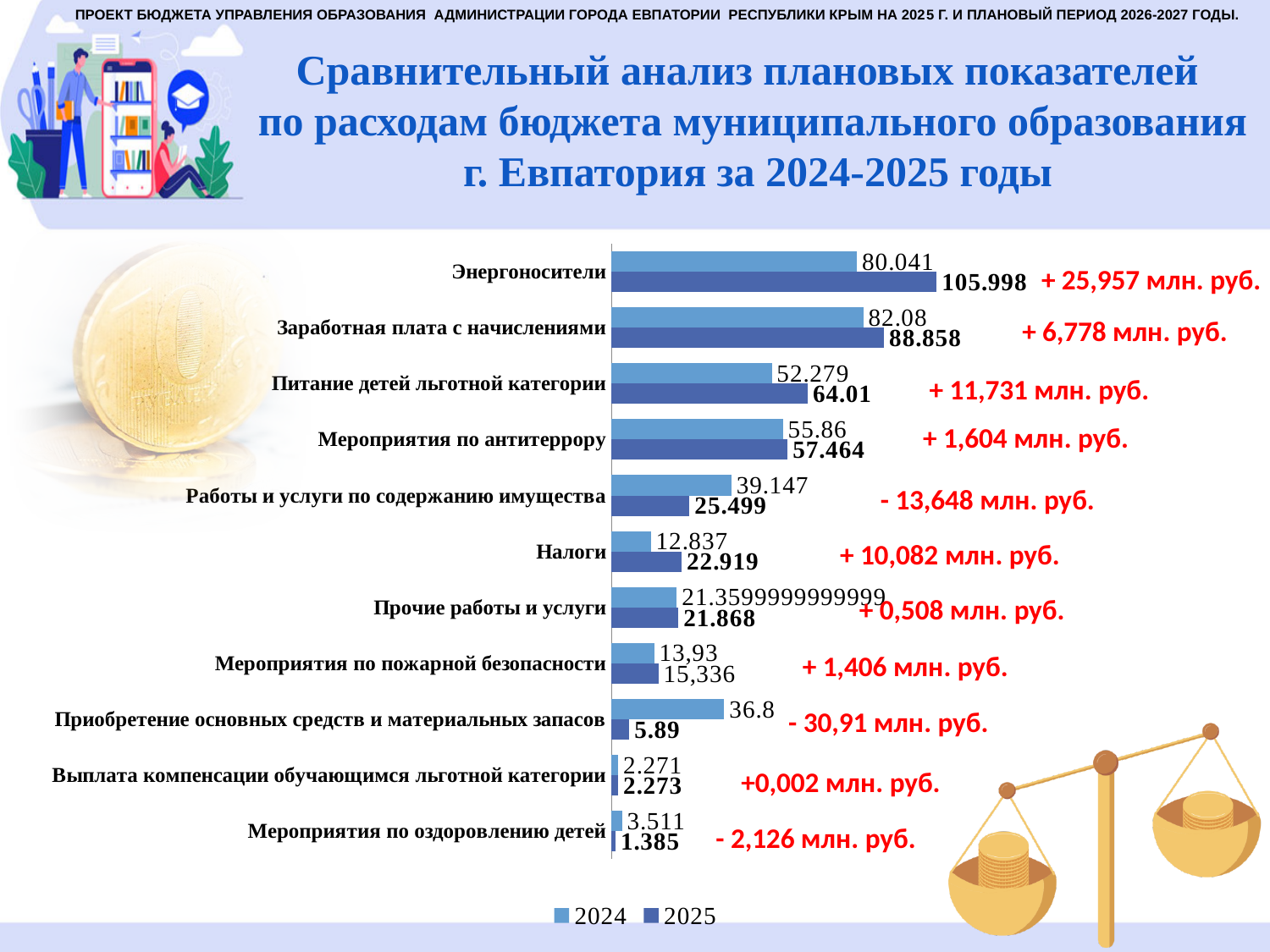
For Работы и услуги по содержанию имущества, which year has the larger value, 2024 or 2025? 2024 What is the 2024 value for Налоги? 12.837 What is the 2025 value for Энергоносители? 105.998 How many categories are shown in the chart? 11 What kind of chart is shown on the slide? Bar chart What is the difference between the 2025 and 2024 values for Энергоносители? 25.957 How many series does the legend list? 2 Which category has the highest 2025 value? Энергоносители Which category has the lowest 2025 value? Мероприятия по оздоровлению детей What is the difference between the 2025 and 2024 values for Налоги? 10.082 What is the 2025 value for Приобретение основных средств и материальных запасов? 5.89 What is the 2024 value for Заработная плата с начислениями? 82.08